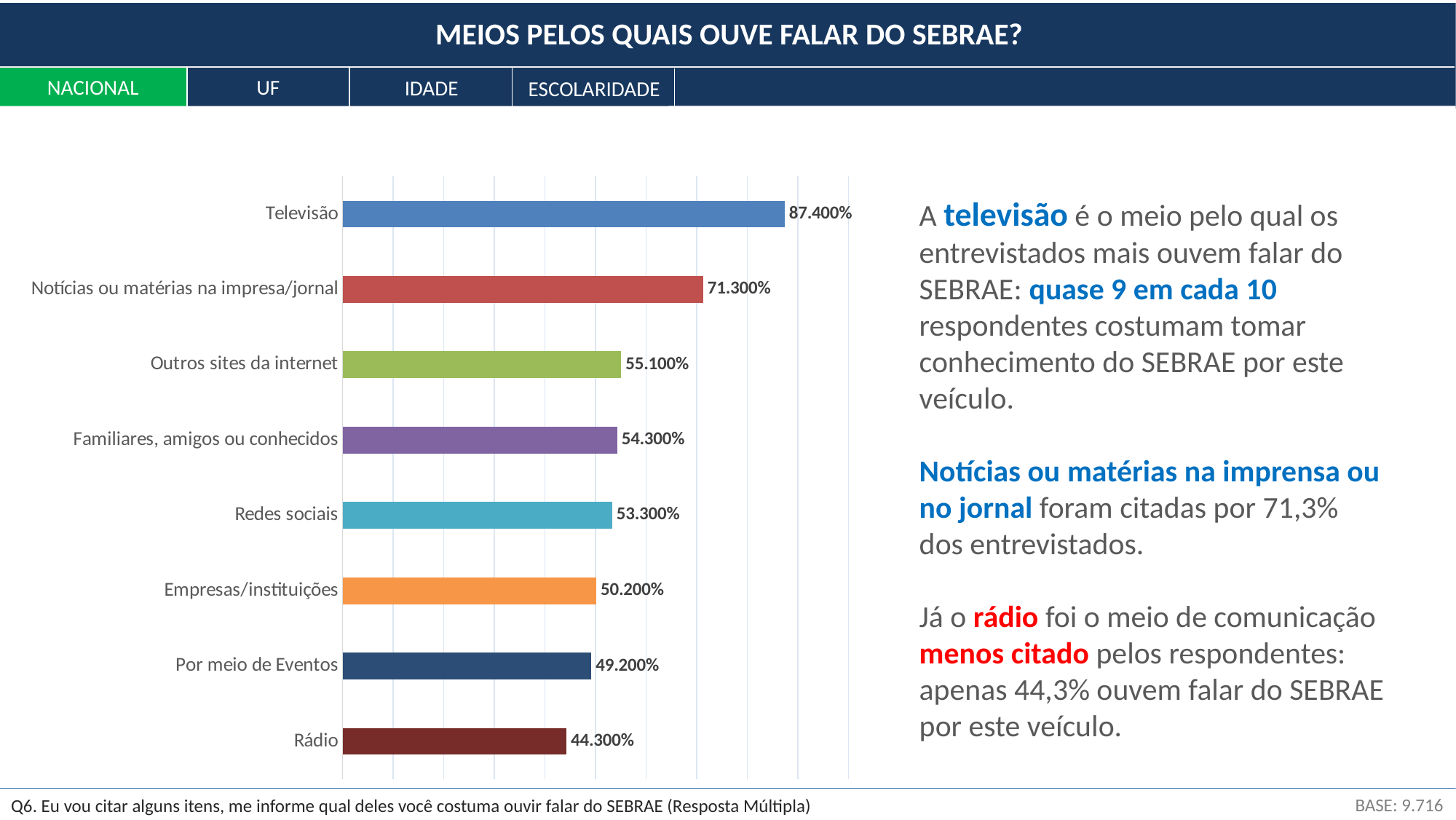
What is the value for Televisão? 87.400% What is the difference between the values for Televisão and Rádio? 43.100% What is the value for Por meio de Eventos? 49.200% Which is larger, the value for Empresas/instituições or the value for Por meio de Eventos? Empresas/instituições What is the value for Redes sociais? 53.300% What kind of chart is shown on the slide? Bar chart What is the difference between the values for Notícias ou matérias na impresa/jornal and Outros sites da internet? 16.200% Which category has the highest value? Televisão Which is larger, the value for Familiares, amigos ou conhecidos or the value for Rádio? Familiares, amigos ou conhecidos What is the title of the slide? MEIOS PELOS QUAIS OUVE FALAR DO SEBRAE? How many categories are shown in the chart? 8 Which category has the lowest value? Rádio